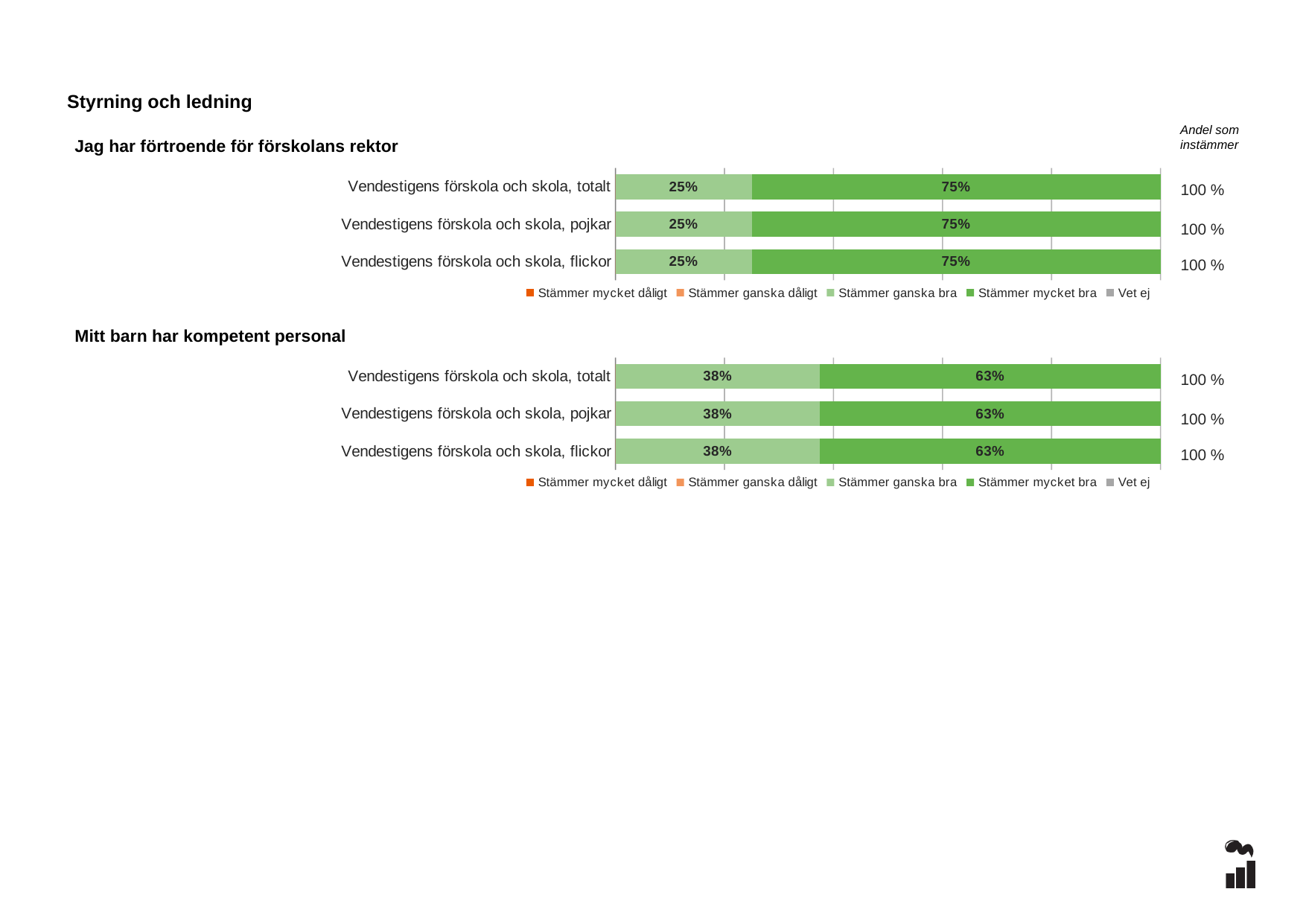
In the chart 'Mitt barn har kompetent personal', what is the difference between 'Stämmer mycket bra' and 'Stämmer ganska bra' for 'Vendestigens förskola och skola, pojkar'? 25% What kind of chart is 'Jag har förtroende för förskolans rektor'? Stacked bar chart In the chart 'Jag har förtroende för förskolans rektor', what is the value of 'Stämmer mycket bra' for 'Vendestigens förskola och skola, totalt'? 75% What is the first legend entry in the chart 'Mitt barn har kompetent personal'? Stämmer mycket dåligt In the chart 'Jag har förtroende för förskolans rektor', what is the 'Andel som instämmer' value shown for 'Vendestigens förskola och skola, totalt'? 100 % In the chart 'Mitt barn har kompetent personal', what is the value of 'Stämmer ganska bra' for 'Vendestigens förskola och skola, flickor'? 38% In the chart 'Jag har förtroende för förskolans rektor', what is the value of 'Stämmer ganska bra' for 'Vendestigens förskola och skola, pojkar'? 25% In the chart 'Mitt barn har kompetent personal', which is larger for 'Vendestigens förskola och skola, totalt': 'Stämmer ganska bra' or 'Stämmer mycket bra'? Stämmer mycket bra In the chart 'Jag har förtroende för förskolans rektor', what is the difference between 'Stämmer mycket bra' and 'Stämmer ganska bra' for 'Vendestigens förskola och skola, flickor'? 50% How many series does the legend list in the chart 'Mitt barn har kompetent personal'? 5 In the chart 'Mitt barn har kompetent personal', what is the value of 'Stämmer mycket bra' for 'Vendestigens förskola och skola, totalt'? 63% How many categories (bars) are shown in the chart 'Jag har förtroende för förskolans rektor'? 3